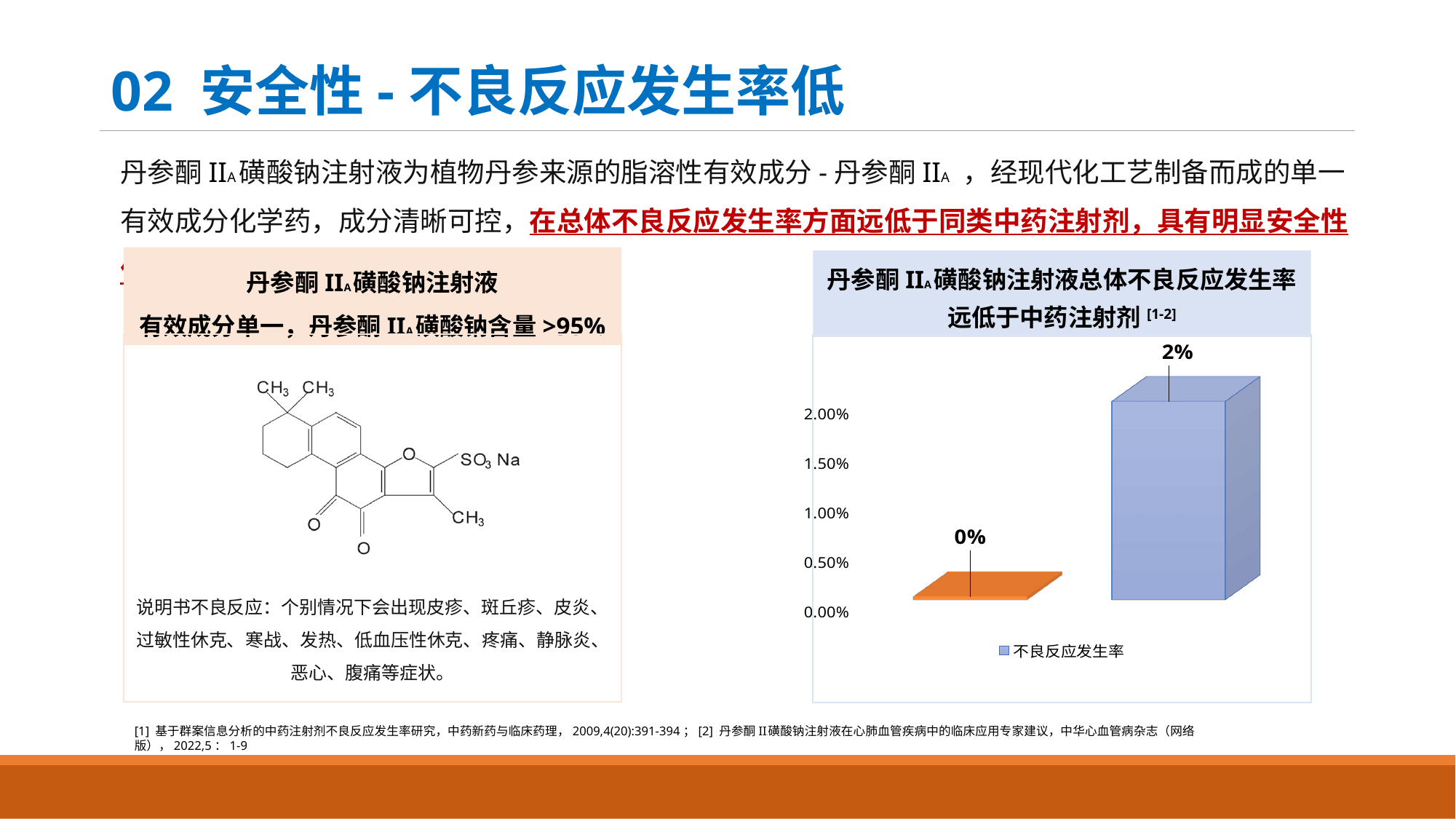
Is the value of the blue bar on the right larger or smaller than the value of the orange bar on the left? larger How many series does the chart legend list? 1 Which bar in the chart is the highest, the orange one on the left or the blue one on the right? the blue bar on the right How many bars are plotted in the chart? 2 Which bar in the chart is the lowest, the orange one on the left or the blue one on the right? the orange bar on the left What is the difference between the value of the blue bar and the value of the orange bar in the chart? 2% What is the highest tick value shown on the chart's vertical axis? 2.00% Is the value of the blue bar on the right greater or less than 1.00%? greater What kind of chart is shown on the slide? bar chart What is the legend entry of the chart? 不良反应发生率 What value is labelled on the orange bar on the left of the chart? 0% What value is labelled on the blue bar on the right of the chart? 2%